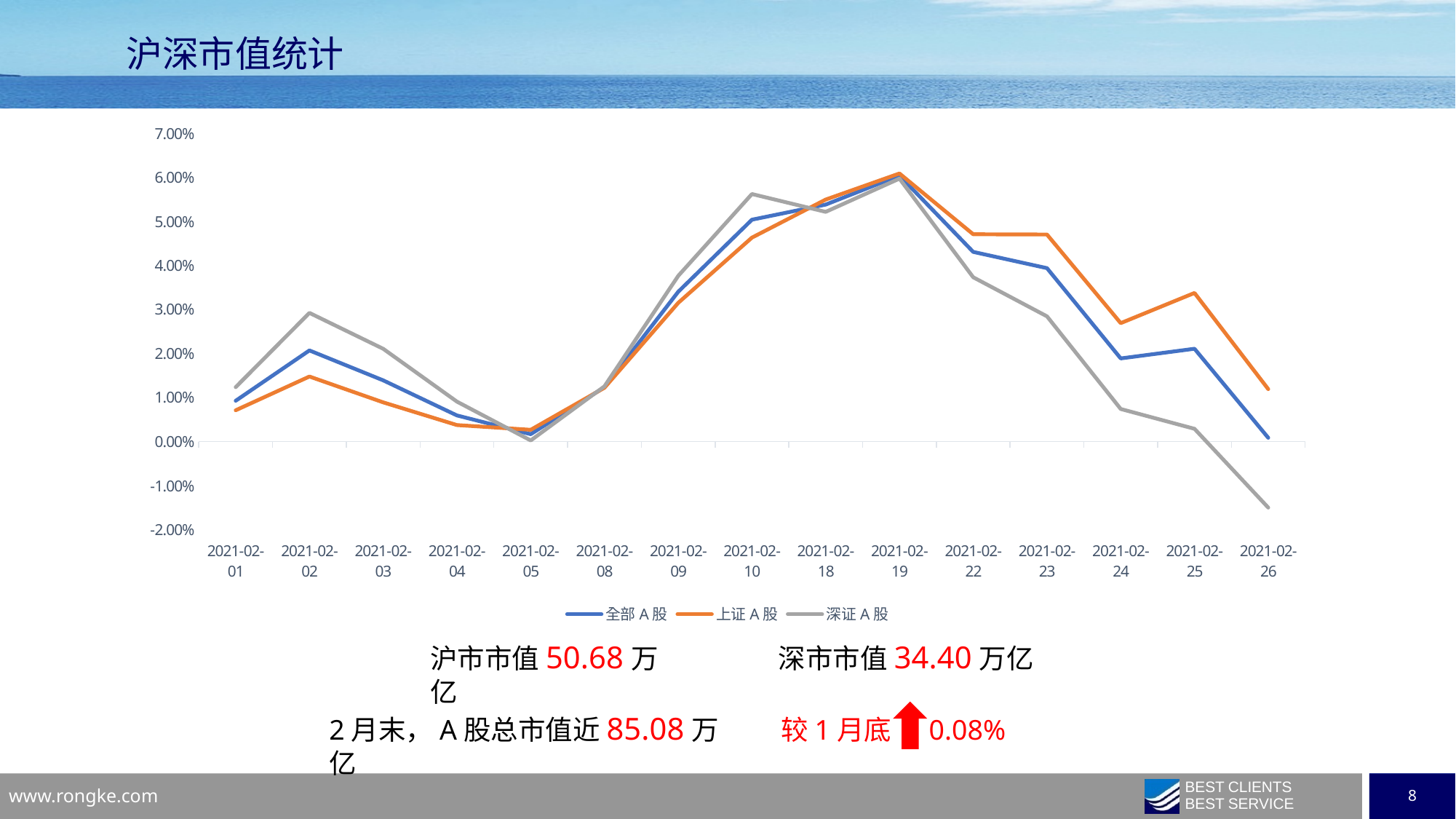
On which date does 上证A股 reach its highest value? 2021-02-19 On 2021-02-02, which is larger: 深证A股 or 上证A股? 深证A股 Does the 深证A股 line rise or fall from 2021-02-19 to 2021-02-26? fall On which date does 深证A股 reach its lowest value? 2021-02-26 Is the value for 深证A股 on 2021-02-26 greater or less than 0.00%? less What is the title of the slide containing the chart? 沪深市值统计 Is the value for 上证A股 on 2021-02-19 greater or less than 5.00%? greater On 2021-02-26, which is larger: 上证A股 or 深证A股? 上证A股 How many series does the legend list? 3 What kind of chart is shown on the slide? line chart How many dates are plotted along the x axis? 15 Is the value for 全部A股 on 2021-02-24 greater or less than 3.00%? less